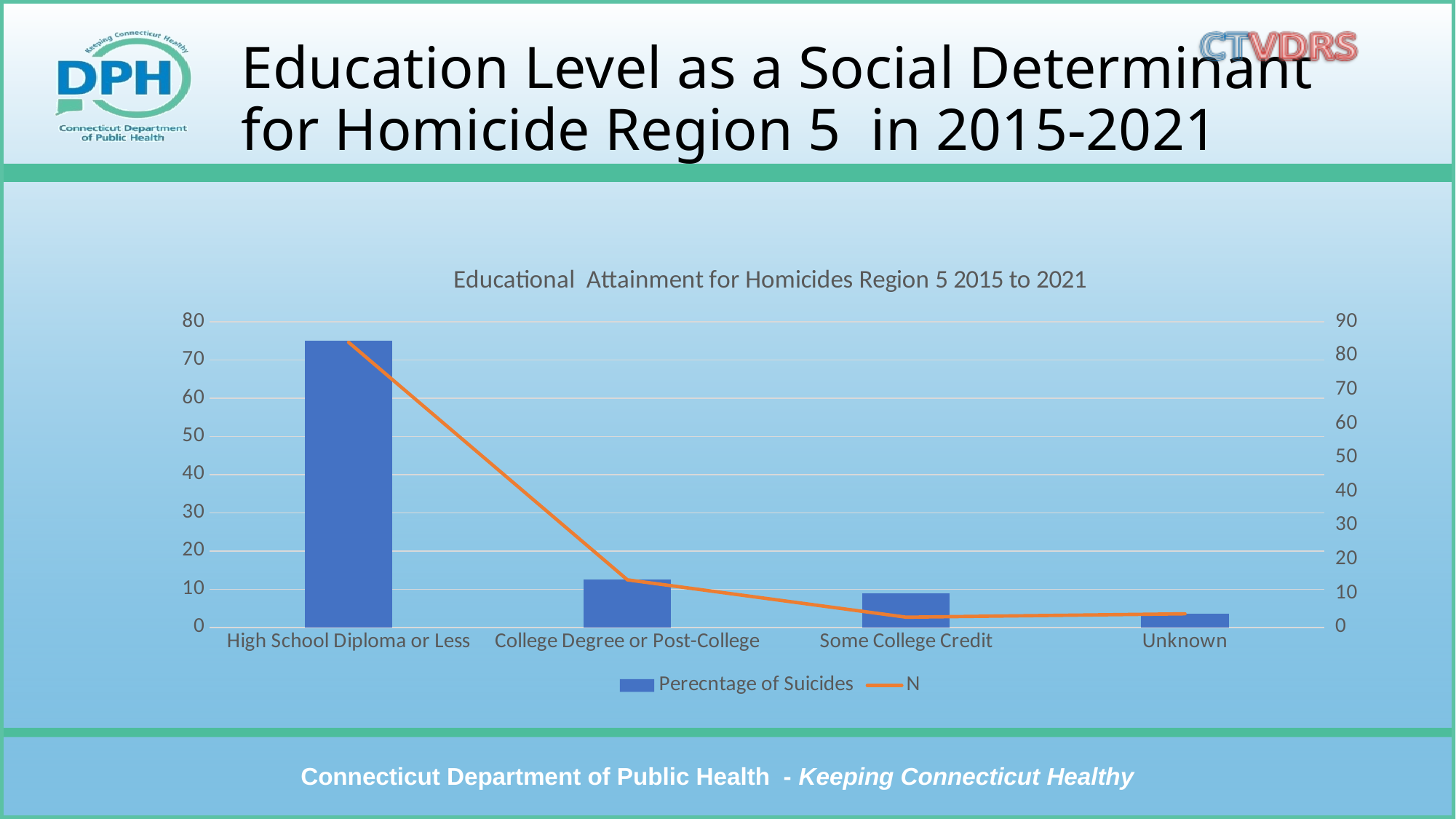
Which has a taller Percentage of Suicides bar, College Degree or Post-College or Some College Credit? College Degree or Post-College Is the Percentage of Suicides bar for High School Diploma or Less greater or less than 70? greater How many education categories are shown on the x axis? 4 Which category has the highest Percentage of Suicides bar? High School Diploma or Less Is the N value for High School Diploma or Less greater or less than 70 on the right axis? greater What kind of chart is shown on the slide? A combined bar and line chart Is the Percentage of Suicides bar for Unknown greater or less than 10? less Which category has the lowest Percentage of Suicides bar? Unknown How many series does the legend list? 2 Do the Percentage of Suicides bars rise or fall from left to right across the categories? fall What is the title of the chart? Educational Attainment for Homicides Region 5 2015 to 2021